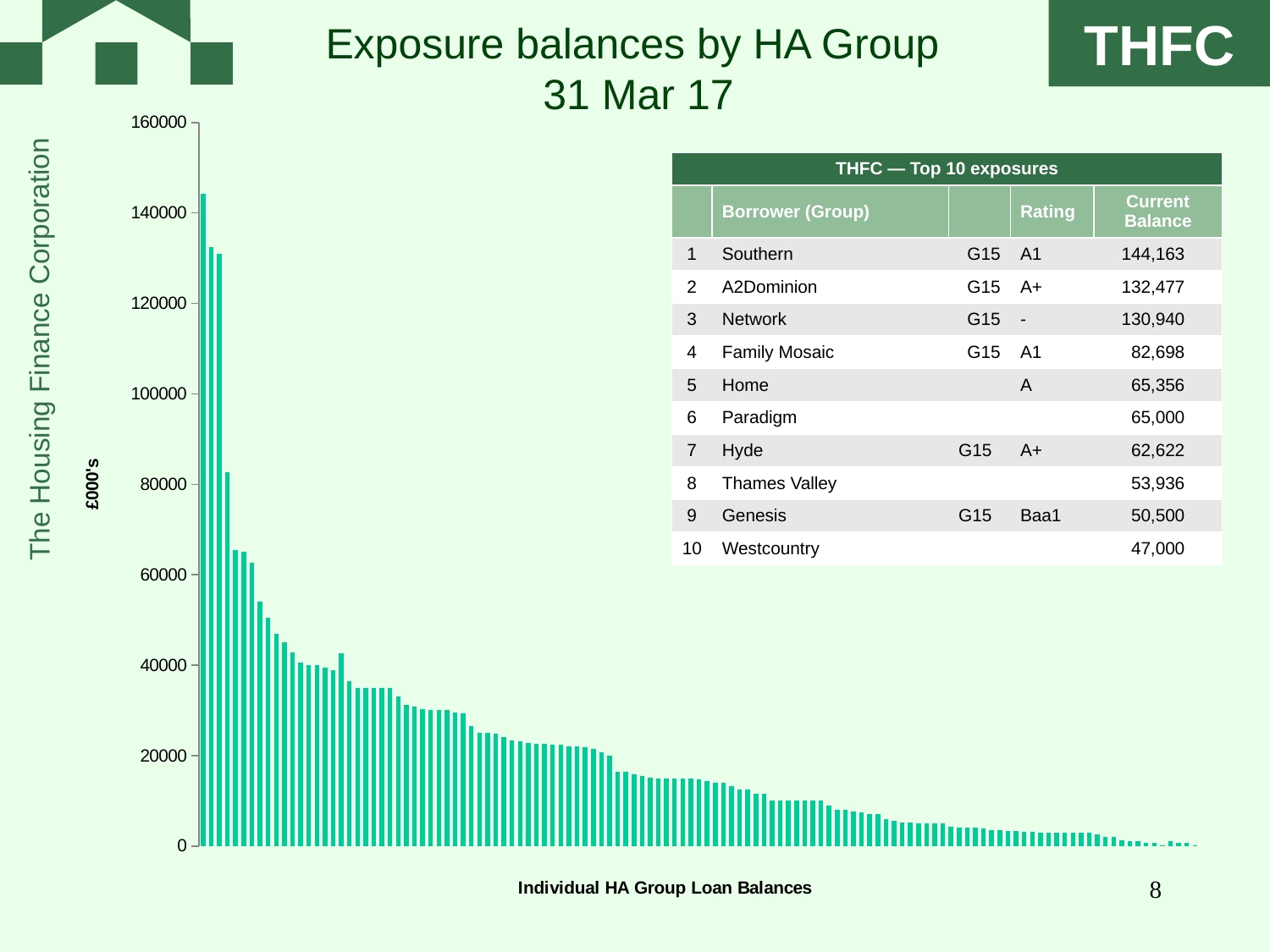
What is the label on the y axis of the chart? £000's Is the value of the fourth tallest bar greater or less than 100000? less Is the value of the second tallest bar greater or less than 120000? greater Is the value of the second tallest bar greater or less than 140000? less What kind of chart is shown on the slide? bar chart Do the bar values rise or fall moving from left to right along the x axis? fall What is the title shown below the chart's x axis? Individual HA Group Loan Balances